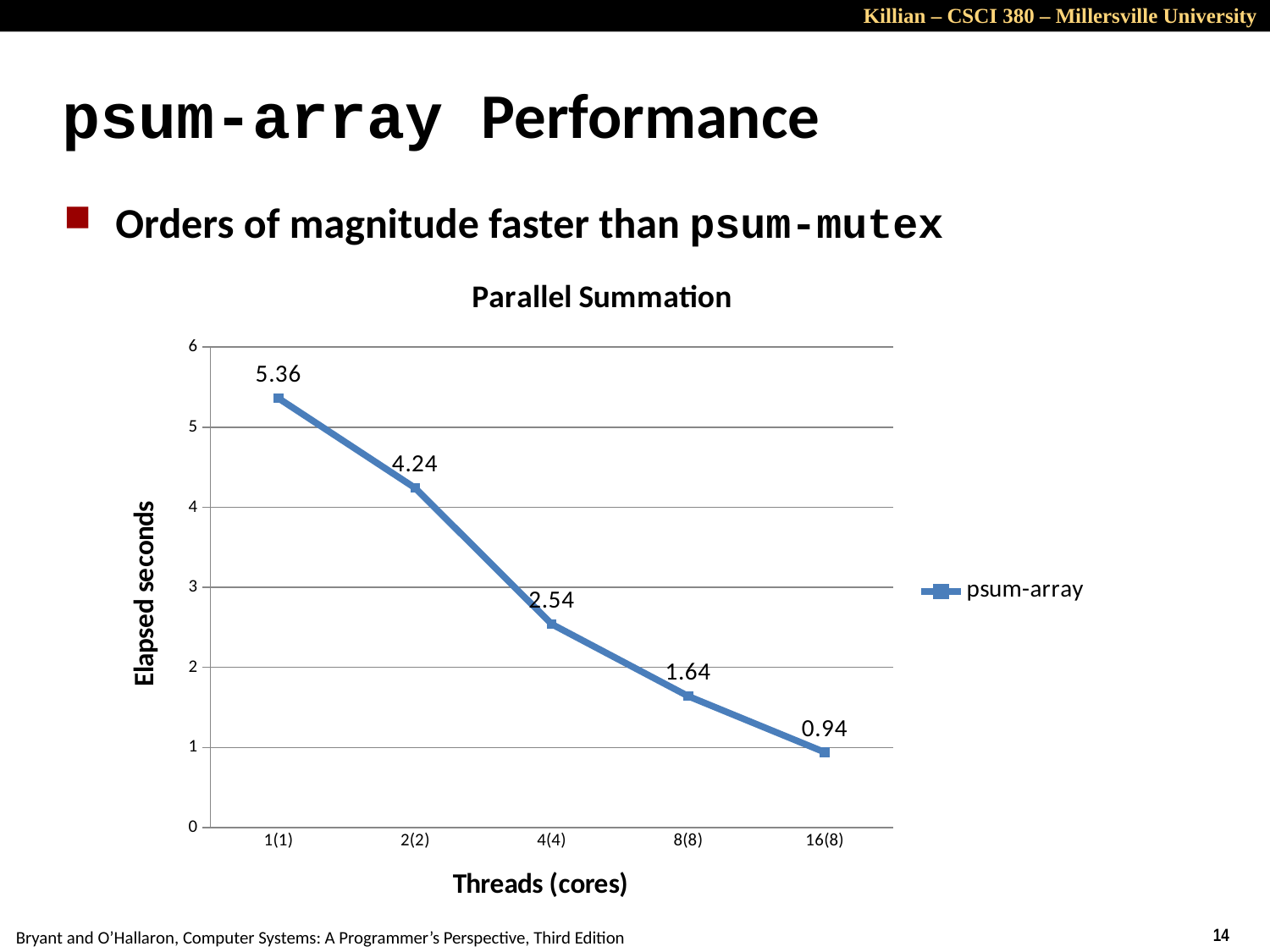
What kind of chart is shown on the slide? line chart How many data points are plotted on the chart? 5 Is the value for 8(8) threads greater or less than 2? less Which has a larger elapsed seconds value, 2(2) or 4(4) threads? 2(2) What is the difference in elapsed seconds between 2(2) and 8(8) threads? 2.6 What is the elapsed seconds value for 1(1) threads (cores)? 5.36 Do the elapsed seconds rise or fall as the number of threads increases along the x axis? fall How many series does the legend list? 1 What is the elapsed seconds value for 4(4) threads (cores)? 2.54 What is the elapsed seconds value for 16(8) threads (cores)? 0.94 Which threads (cores) category has the highest elapsed seconds? 1(1) Which threads (cores) category has the lowest elapsed seconds? 16(8)